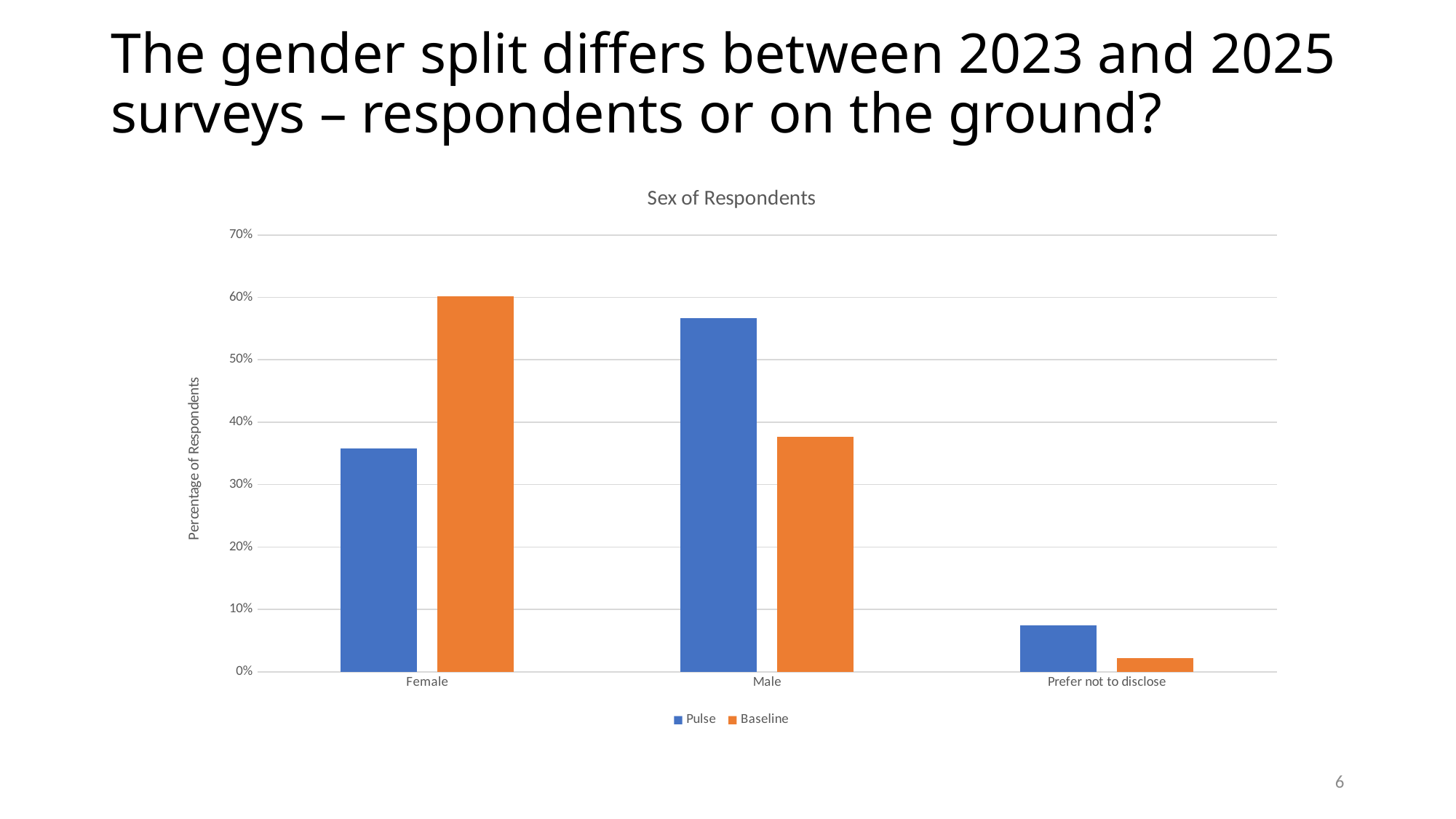
How many series does the legend list? 2 Which category has the highest Baseline value? Female For Male, which series is larger, Pulse or Baseline? Pulse What is the title of the chart? Sex of Respondents What type of chart is shown on the slide? Bar chart How many categories are shown on the x axis? 3 For Female, which series is larger, Pulse or Baseline? Baseline Is the Pulse value for Male greater or less than 50%? greater Is the Pulse value for Female greater or less than 40%? less Which category has the lowest Baseline value? Prefer not to disclose Which category has the highest Pulse value? Male Is the Pulse value for Prefer not to disclose greater or less than 10%? less